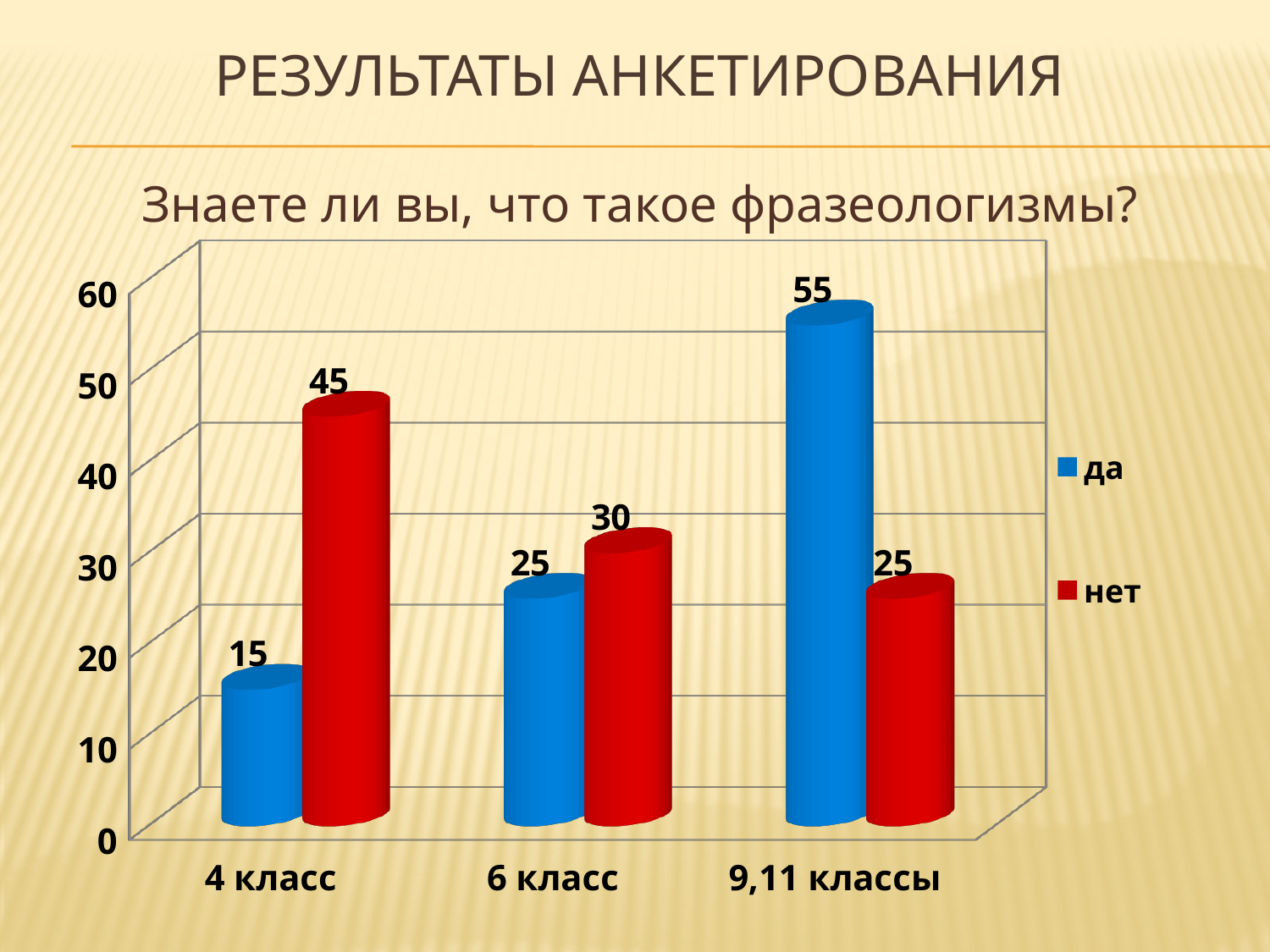
Which category has the lowest value for the "нет" series? 9,11 классы Which category has the highest value for the "да" series? 9,11 классы What is the value for "да" in the "4 класс" category? 15 What is the title of the chart? Знаете ли вы, что такое фразеологизмы? How many categories are shown on the x axis? 3 How many series does the legend list? 2 What is the value for "нет" in the "4 класс" category? 45 What is the value for "да" in the "9,11 классы" category? 55 What is the value for "нет" in the "6 класс" category? 30 What kind of chart is shown on the slide? bar chart What is the difference between the "нет" and "да" values in the "4 класс" category? 30 In the "6 класс" category, which is larger: "да" or "нет"? нет